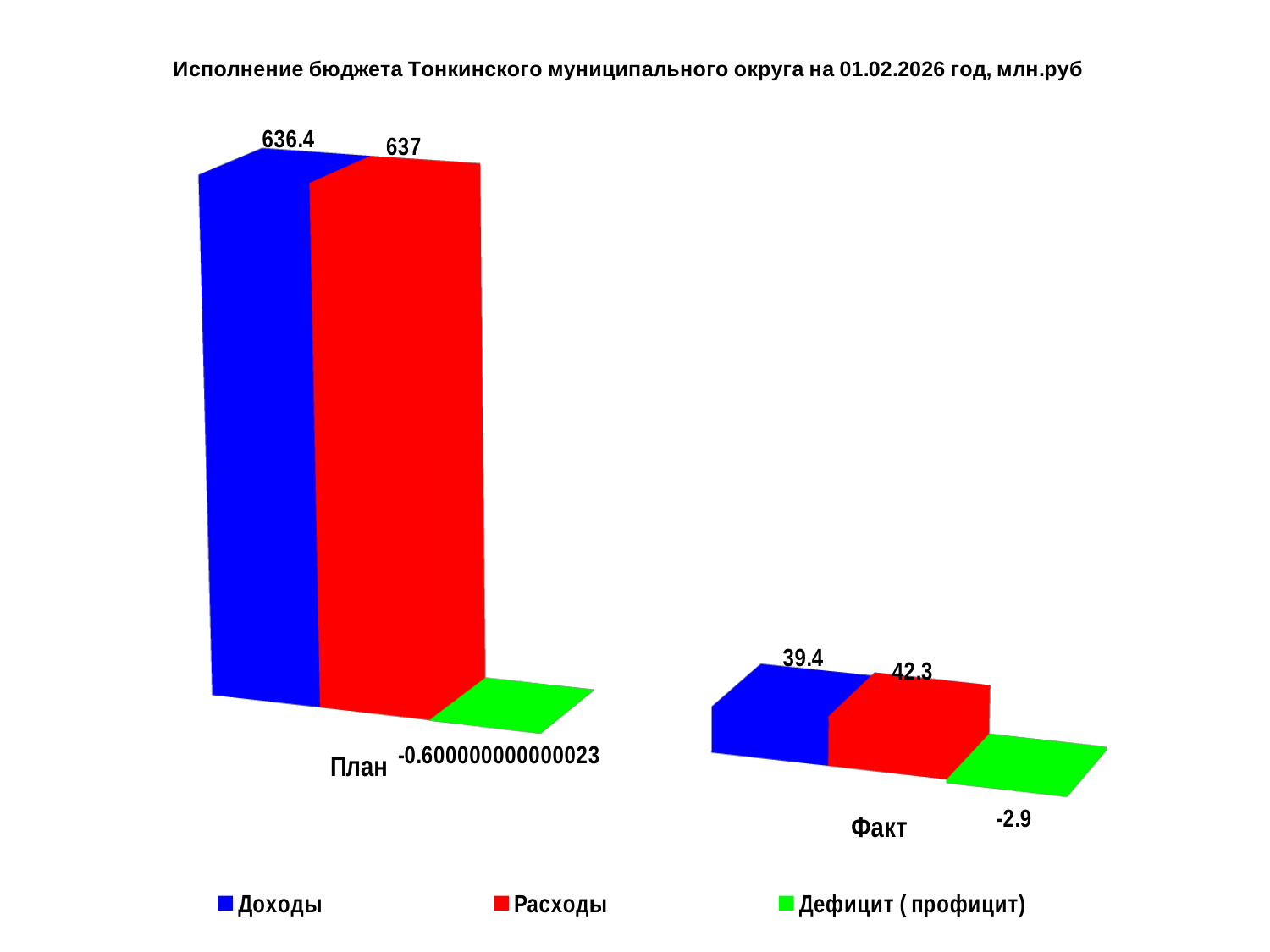
What is the difference between Расходы and Доходы for Факт? 2.9 What is the value of Доходы for Факт? 39.4 What is the value of Расходы for План? 637 What kind of chart is shown on the slide? Bar chart How many series does the legend list? 3 What is the value of Доходы for План? 636.4 What is the value of Расходы for Факт? 42.3 Which category has the higher Доходы value, План or Факт? План Which is larger for Факт, Доходы or Расходы? Расходы What is the value of Дефицит (профицит) for Факт? -2.9 What colour represents the Расходы series? Red How many categories are shown on the x axis? 2